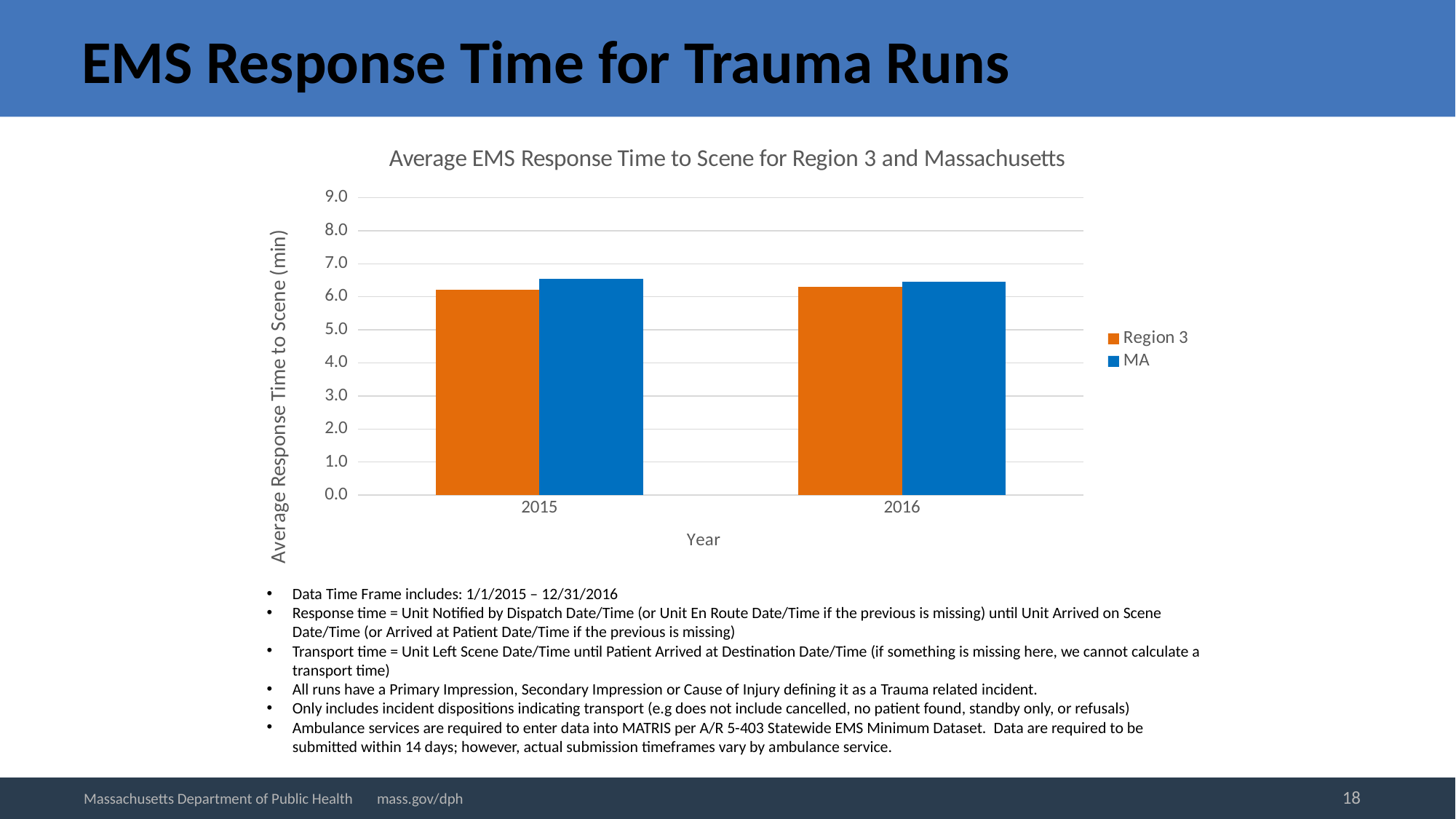
Is the value for Region 3 in 2015 greater or less than 5.0? greater How many years are shown on the x axis? 2 What kind of chart is shown on the slide? bar chart Is the value for MA in 2015 greater or less than 7.0? less Is the value for Region 3 in 2016 greater or less than 7.0? less What is the label of the vertical axis? Average Response Time to Scene (min) How many series does the legend list? 2 What is the title of the chart? Average EMS Response Time to Scene for Region 3 and Massachusetts In 2015, which is larger, the value for Region 3 or the value for MA? MA